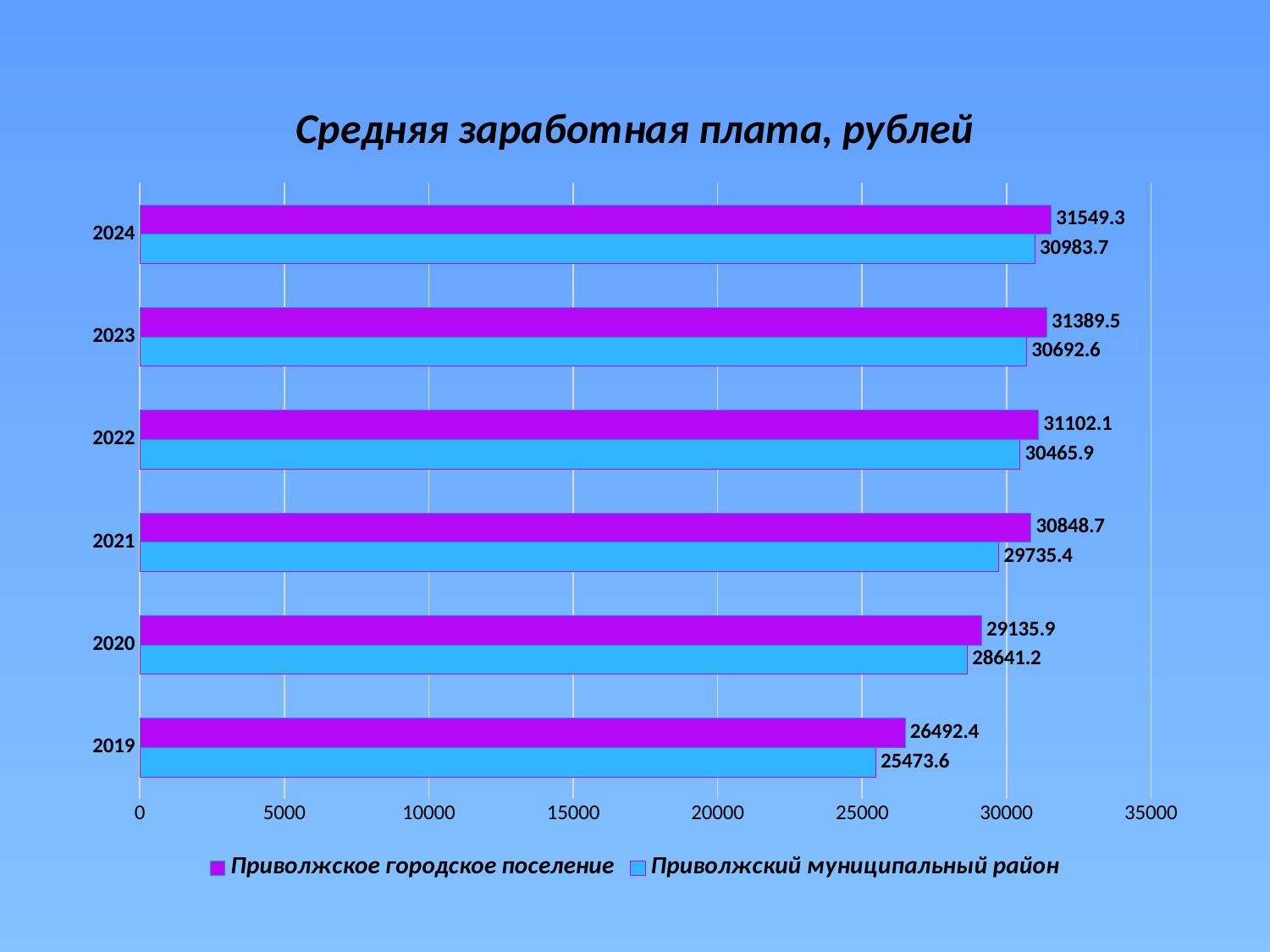
How many series does the legend list? 2 How many years are shown on the chart? 6 In which year is the value for Приволжский муниципальный район the lowest? 2019 What is the value for Приволжское городское поселение in 2020? 29135.9 What is the difference between Приволжское городское поселение and Приволжский муниципальный район in 2024? 565.6 What is the average salary for Приволжское городское поселение in 2024? 31549.3 What type of chart is shown on the slide? Bar chart In which year is the value for Приволжское городское поселение the highest? 2024 What is the difference between Приволжское городское поселение and Приволжский муниципальный район in 2019? 1018.8 What is the value for Приволжский муниципальный район in 2022? 30465.9 What is the average salary for Приволжский муниципальный район in 2019? 25473.6 Which series has the larger value in 2021, Приволжское городское поселение or Приволжский муниципальный район? Приволжское городское поселение